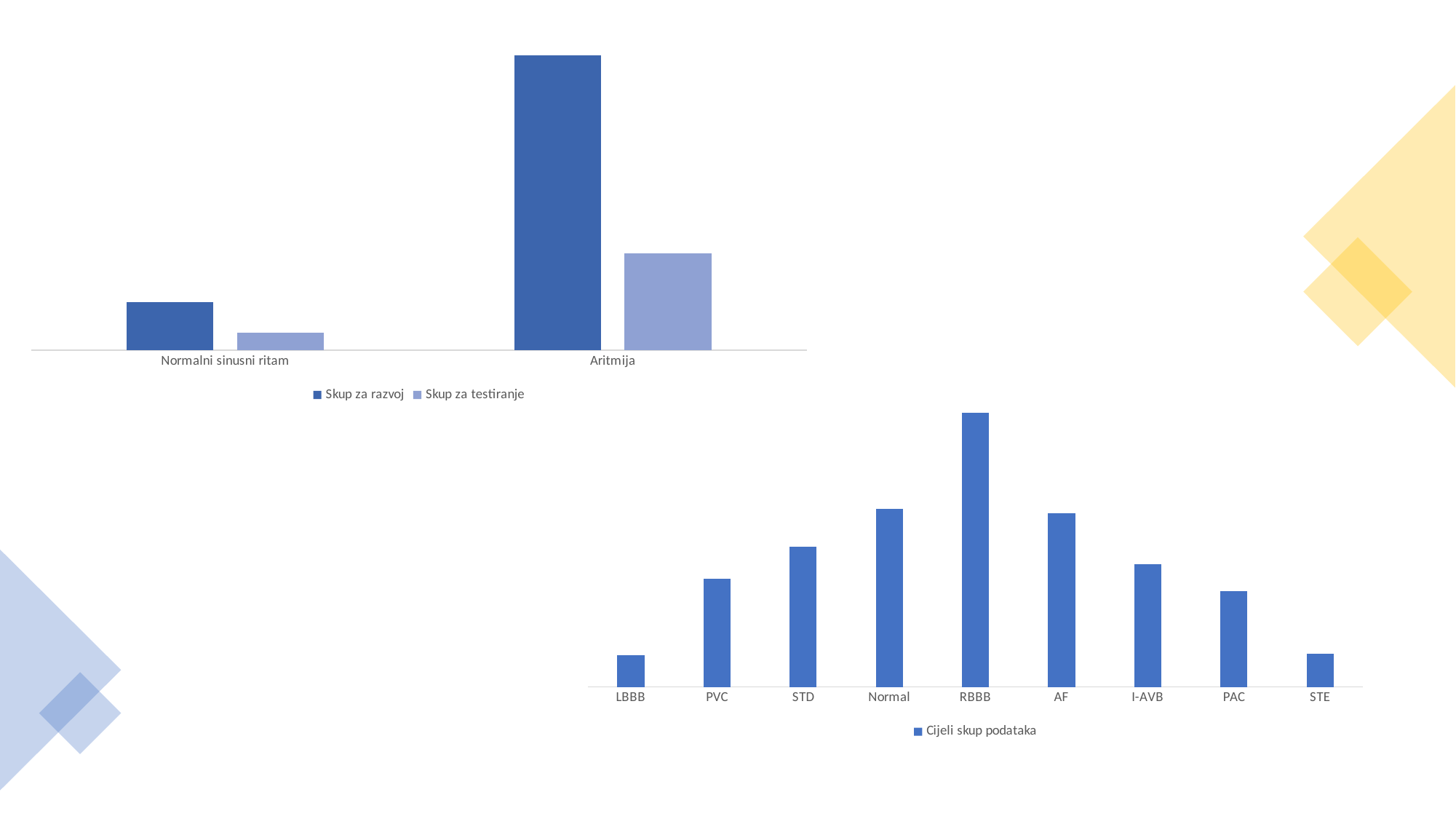
In the bottom-right chart, which category has the highest value? RBBB In the bottom-right chart, which has the larger value: Normal or PAC? Normal How many categories are shown on the x axis of the top-left chart? 2 In the top-left chart, which category has the highest value for the series Skup za razvoj? Aritmija How many categories are shown on the x axis of the bottom-right chart? 9 How many series does the legend of the top-left chart list? 2 In the bottom-right chart, which category has the lowest value? LBBB In the top-left chart, which series is drawn in the darker blue colour? Skup za razvoj What kind of chart is the top-left chart? Bar chart In the top-left chart, for the category Aritmija, which series has the larger value: Skup za razvoj or Skup za testiranje? Skup za razvoj In the top-left chart, which category has the lowest value for the series Skup za testiranje? Normalni sinusni ritam What is the name of the series shown in the legend of the bottom-right chart? Cijeli skup podataka